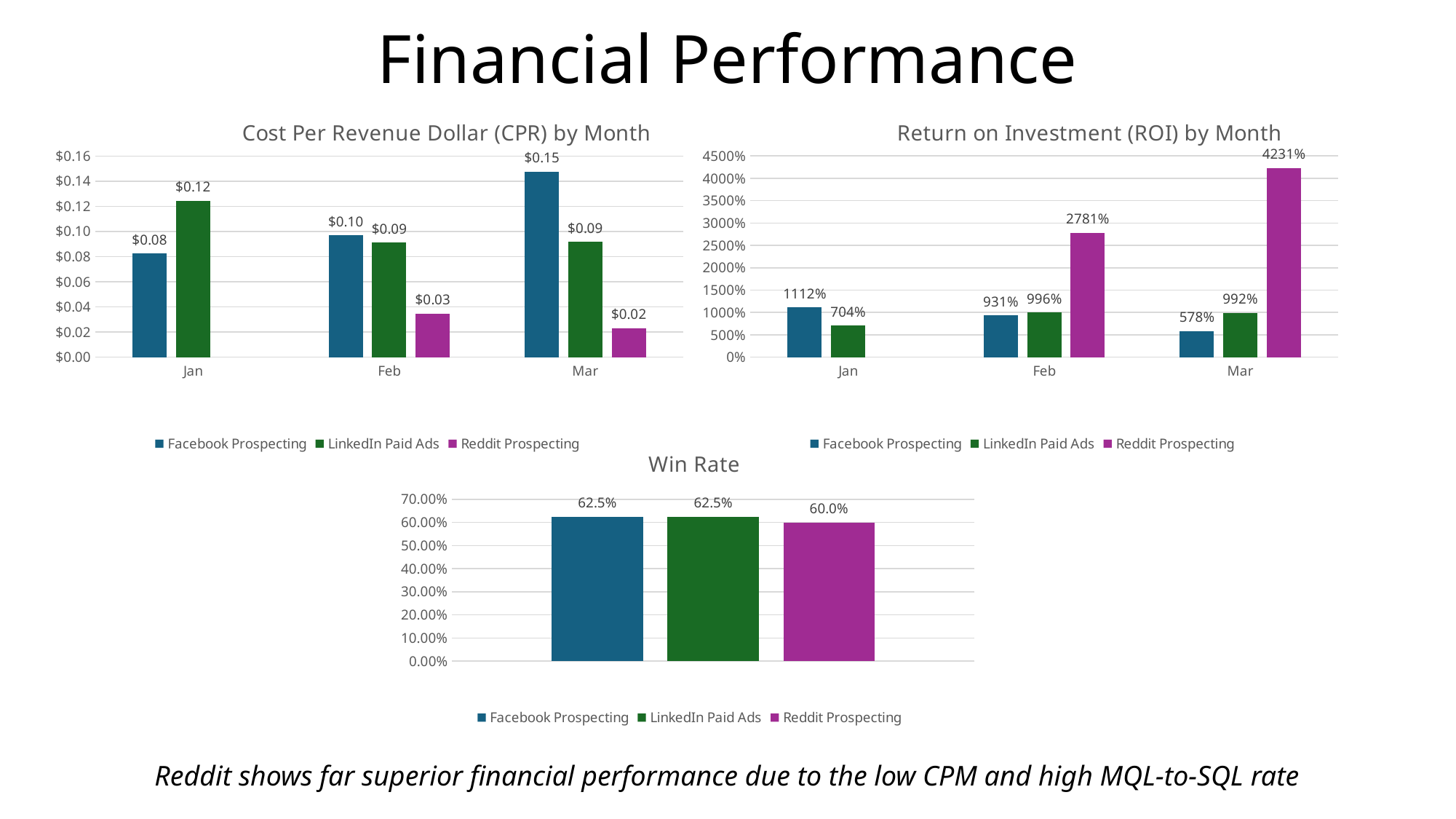
In the 'Cost Per Revenue Dollar (CPR) by Month' chart, does the Facebook Prospecting value rise or fall from Jan to Mar? Rise In the 'Win Rate' chart, what is the win rate for Reddit Prospecting? 60.0% In the 'Cost Per Revenue Dollar (CPR) by Month' chart, what is the value for Facebook Prospecting in Mar? $0.15 In the 'Return on Investment (ROI) by Month' chart, what is the difference between the Reddit Prospecting and LinkedIn Paid Ads ROI in Mar? 3239% In the 'Return on Investment (ROI) by Month' chart, is the Reddit Prospecting value for Mar greater or less than 4000%? greater How many series does the legend of the 'Win Rate' chart list? 3 What kind of chart is the 'Win Rate' chart? Bar chart In the 'Return on Investment (ROI) by Month' chart, which series has the highest ROI in Mar? Reddit Prospecting In the 'Return on Investment (ROI) by Month' chart, what is the ROI for Reddit Prospecting in Feb? 2781% In the 'Cost Per Revenue Dollar (CPR) by Month' chart, which series has the lowest CPR in Feb? Reddit Prospecting In the 'Cost Per Revenue Dollar (CPR) by Month' chart, what is the difference between the Facebook Prospecting and Reddit Prospecting values in Mar? $0.13 In the 'Return on Investment (ROI) by Month' chart, which is larger in Jan: Facebook Prospecting or LinkedIn Paid Ads? Facebook Prospecting